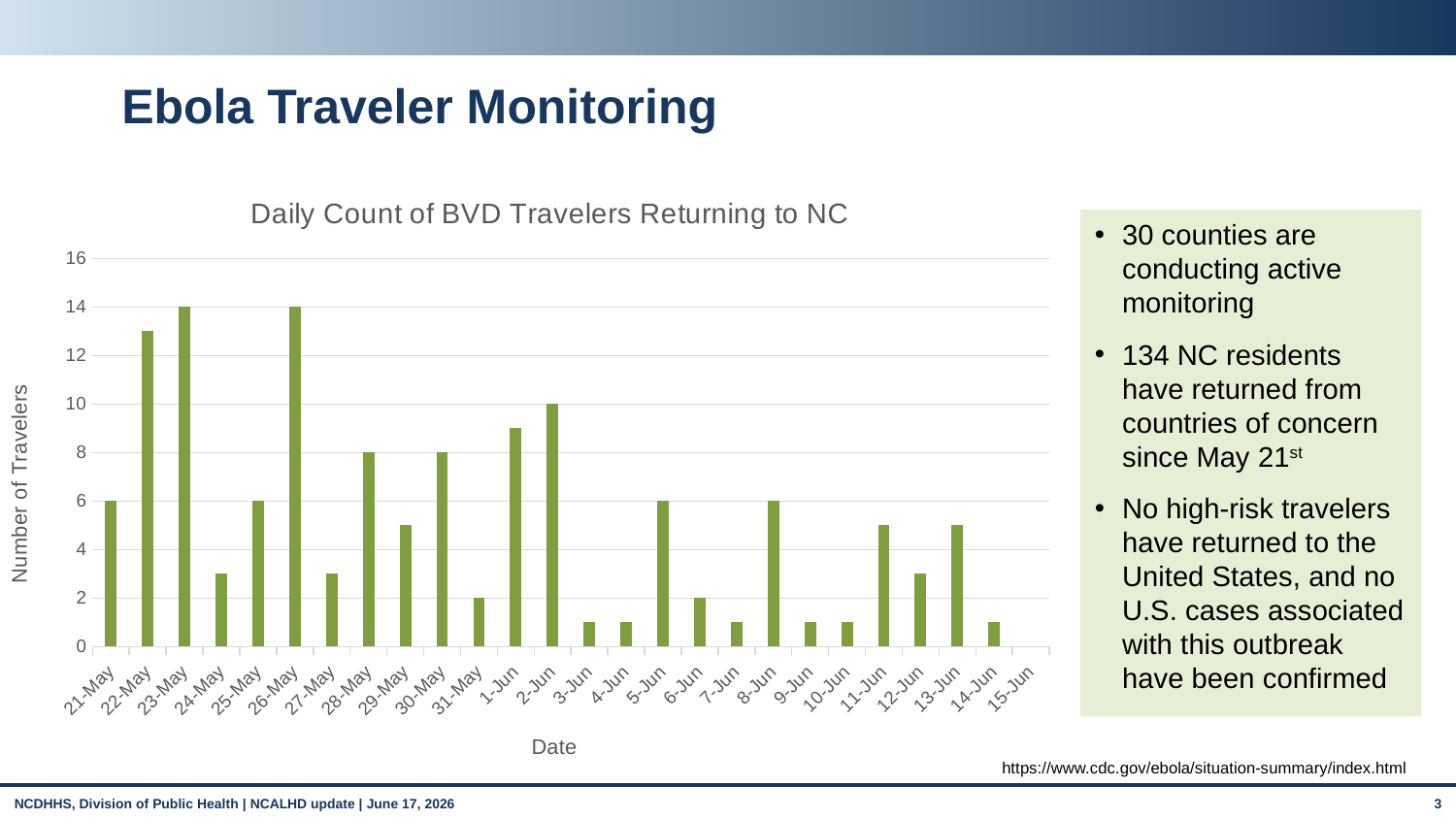
What is the label of the vertical axis? Number of Travelers Which date has the larger count, 22-May or 24-May? 22-May What is the difference between the counts for 23-May and 28-May? 6 What is the title of the chart? Daily Count of BVD Travelers Returning to NC Is the value for 22-May greater or less than 12? greater Is the value for 3-Jun greater or less than 2? less What kind of chart is shown on the slide? Bar chart What is the highest daily count shown on the chart? 14 How many travelers returned on 2-Jun? 10 How many dates are shown along the x axis? 26 How many travelers returned on 23-May? 14 How many travelers returned on 28-May? 8